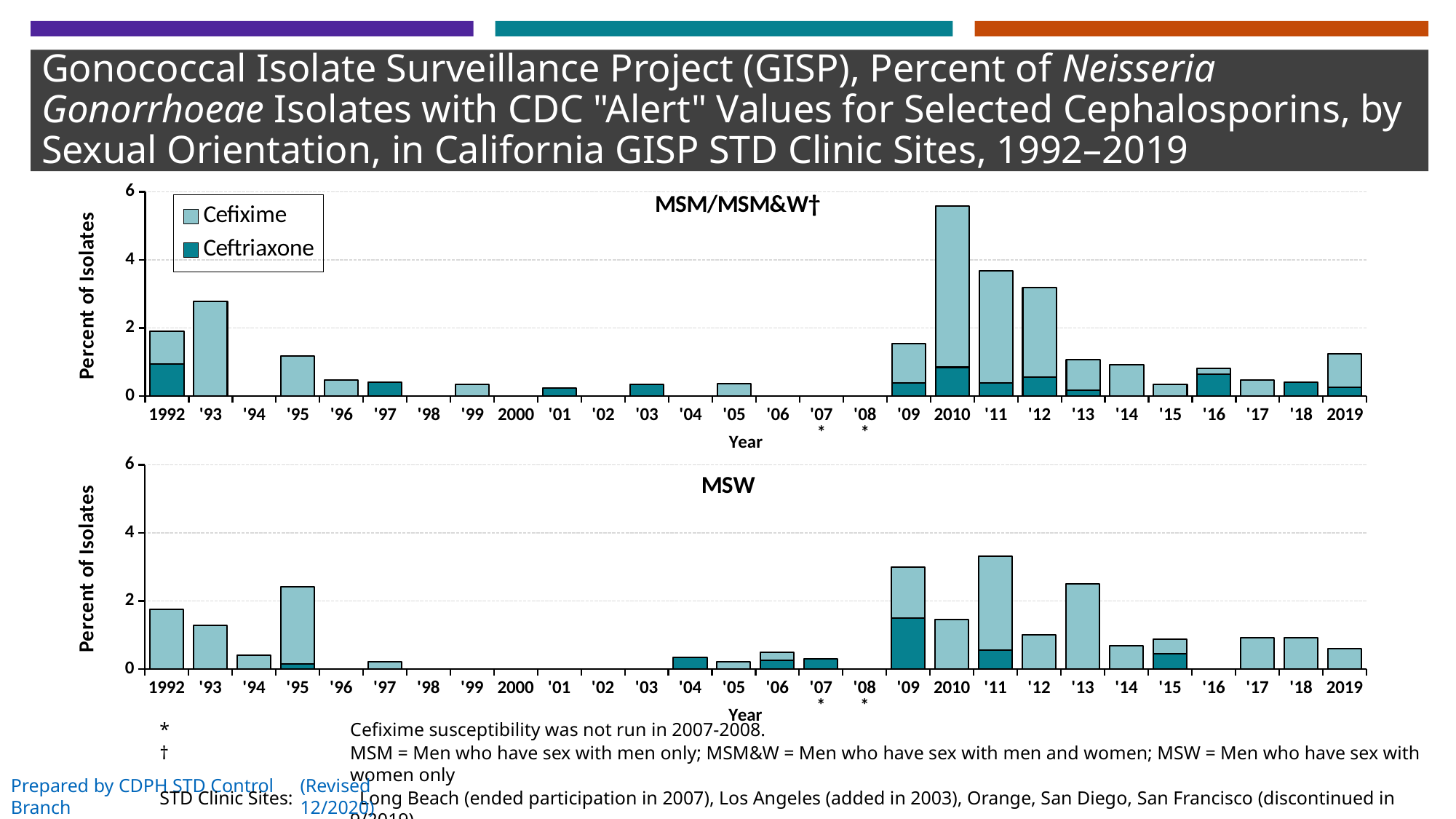
How many series does the legend on the MSM/MSM&W† chart list? 2 In the MSM/MSM&W† chart, which year has the highest total percent of isolates? 2010 In the MSM/MSM&W† chart, is the total value for 1993 greater or less than 2? greater In the MSM/MSM&W† chart, is the total value for 2014 greater or less than 2? less Which series are listed in the legend of the MSM/MSM&W† chart? Cefixime and Ceftriaxone What is the y-axis label on the MSW chart? Percent of Isolates In the MSW chart, is the total value for 2012 greater or less than 2? less What kind of chart is the MSM/MSM&W† chart? stacked bar chart How many years are shown on the x axis of the MSW chart? 28